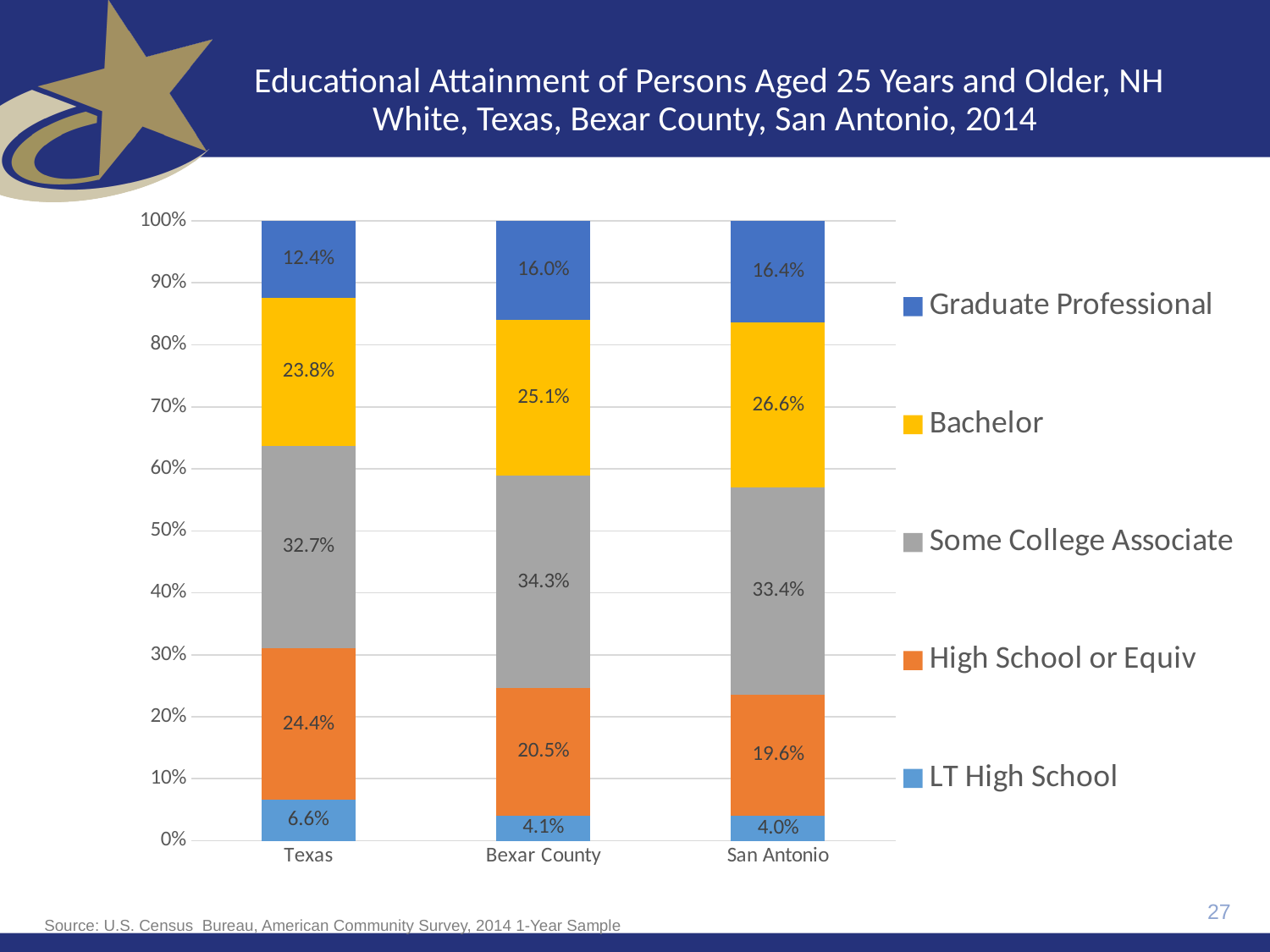
What kind of chart is shown on the slide? Stacked bar chart Which is larger, the Bachelor percentage for Texas or for San Antonio? San Antonio What is the Graduate Professional percentage for San Antonio? 16.4% Which colour represents the Bachelor series in the legend? Yellow How many series does the legend list? 5 What is the LT High School percentage for Texas? 6.6% How many geographies are shown on the x axis? 3 What is the Bachelor percentage for Bexar County? 25.1% Which geography has the highest Some College Associate percentage? Bexar County Which geography has the lowest LT High School percentage? San Antonio Does the Graduate Professional percentage rise or fall from Texas to San Antonio? Rise What is the difference between the High School or Equiv percentage for Texas and for San Antonio? 4.8%